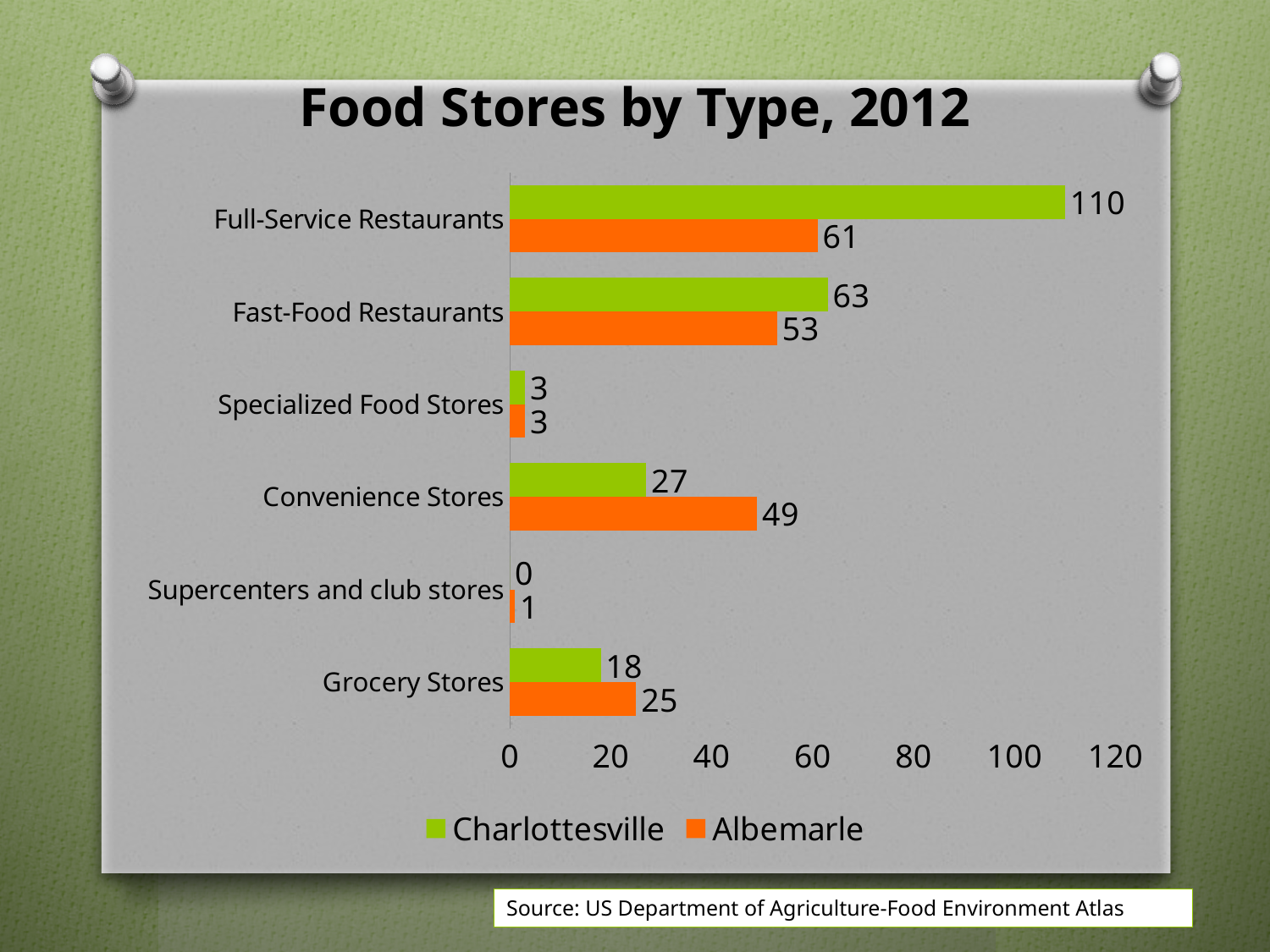
What is the value for Charlottesville for Full-Service Restaurants? 110 What is the difference between the Charlottesville and Albemarle values for Full-Service Restaurants? 49 How many series does the legend list? 2 What kind of chart is shown on the slide? Bar chart How many categories are shown on the chart? 6 Which category has the lowest value for Albemarle? Supercenters and club stores What is the value for Albemarle for Convenience Stores? 49 Which is larger for Fast-Food Restaurants, Charlottesville or Albemarle? Charlottesville What is the difference between the Albemarle and Charlottesville values for Convenience Stores? 22 Which category has the highest value for Charlottesville? Full-Service Restaurants Which is larger for Grocery Stores, Charlottesville or Albemarle? Albemarle What is the value for Albemarle for Grocery Stores? 25